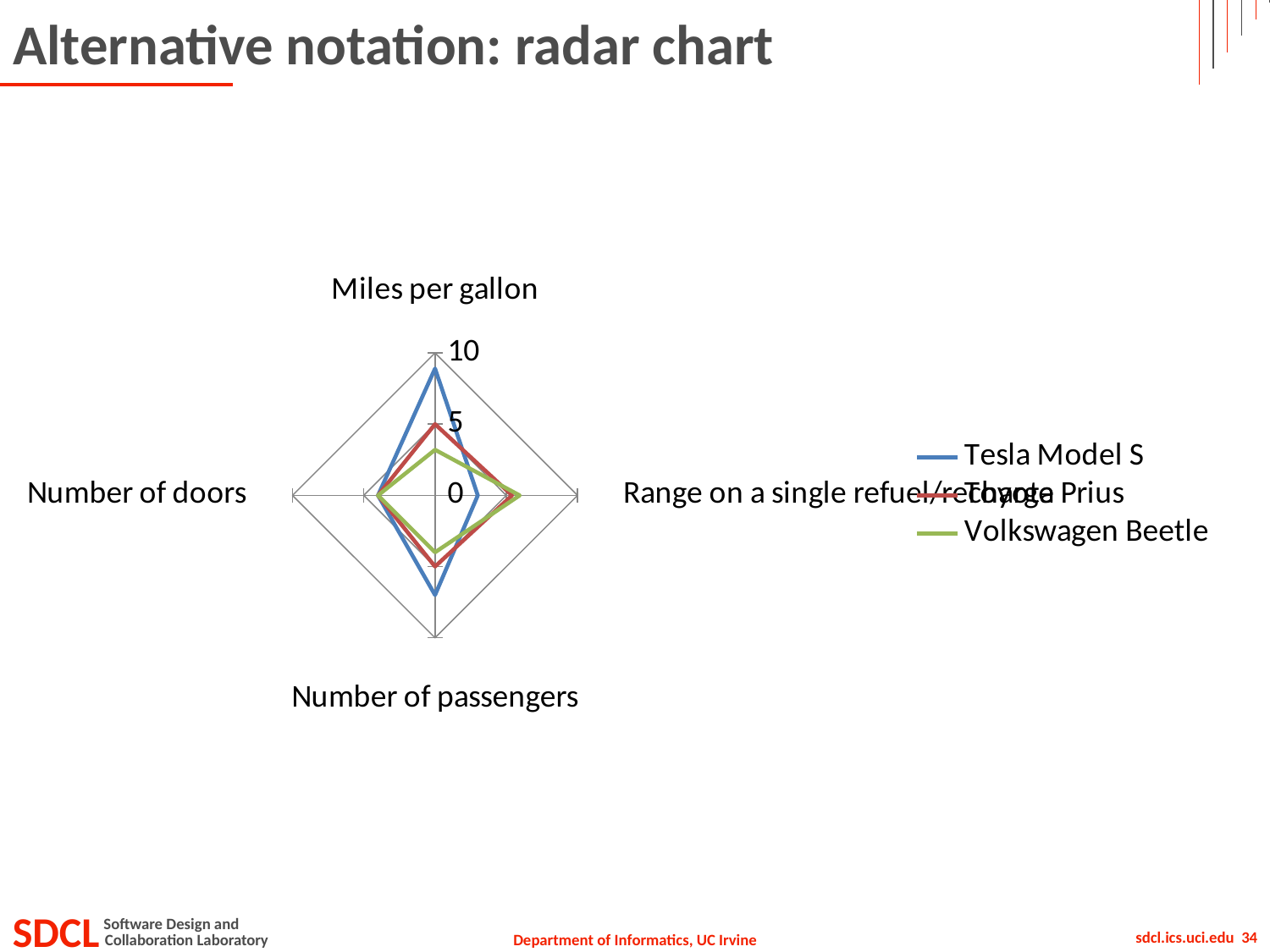
Is the Tesla Model S value for Number of passengers greater or less than 5? greater Which series has the highest value on the Miles per gallon axis? Tesla Model S How many series does the chart's legend list? 3 Which series has the highest value on the Number of passengers axis? Tesla Model S Which series has the lowest value on the Miles per gallon axis? Volkswagen Beetle Which is larger on the Miles per gallon axis: Tesla Model S or Volkswagen Beetle? Tesla Model S What is the highest tick value shown on the chart's axis scale? 10 Which series is drawn in green in the chart? Volkswagen Beetle Is the Volkswagen Beetle value for Miles per gallon greater or less than 5? less Is the Tesla Model S value for Miles per gallon greater or less than 5? greater What kind of chart is shown on the slide? radar chart How many axes (categories) does the radar chart have? 4